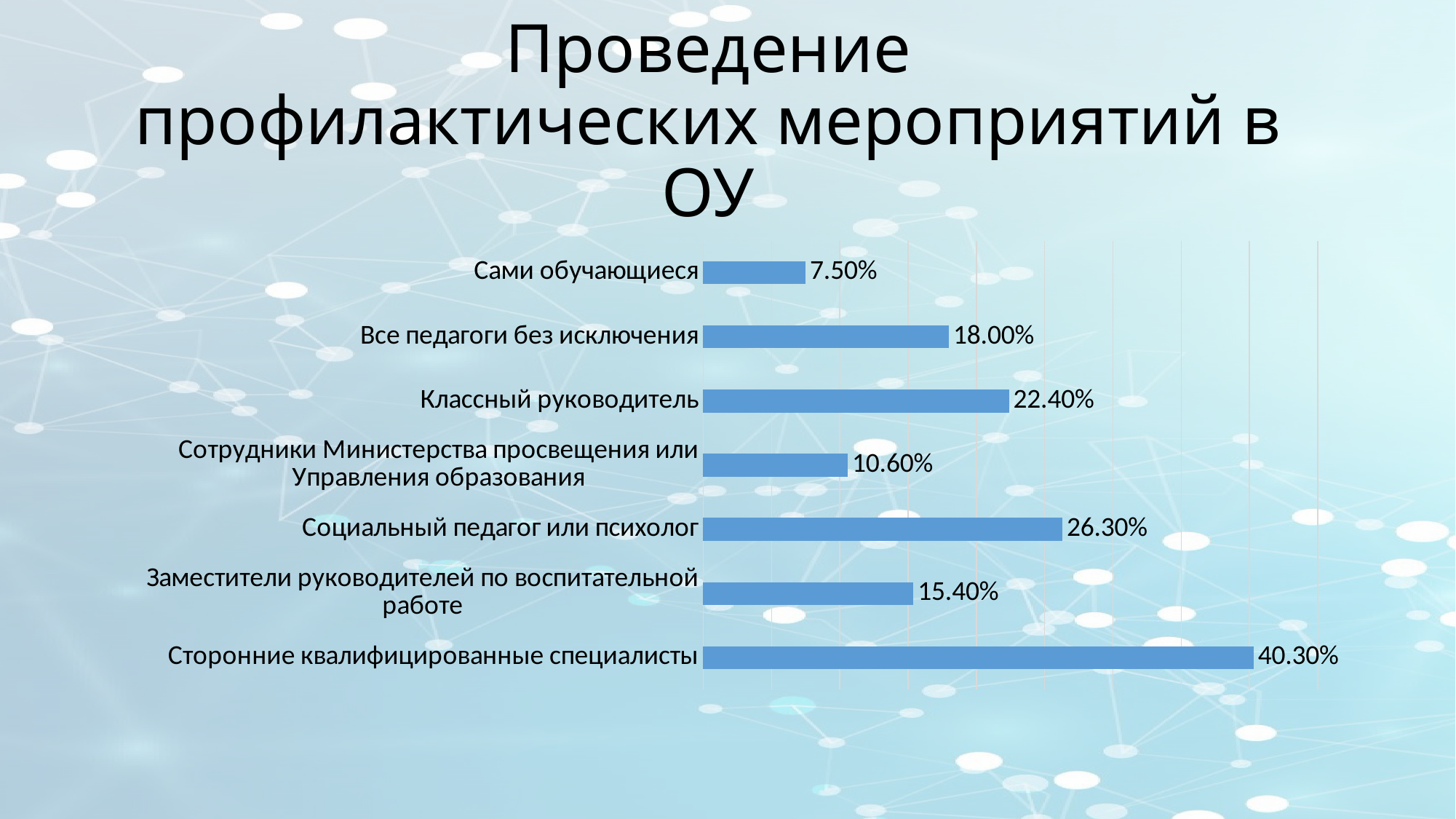
What is the difference between the values for Классный руководитель and Все педагоги без исключения? 4.40% What is the difference between the values for Сторонние квалифицированные специалисты and Сами обучающиеся? 32.80% How many categories are shown in the chart? 7 What is the value for Социальный педагог или психолог? 26.30% What is the value for Сторонние квалифицированные специалисты? 40.30% What is the title of the slide? Проведение профилактических мероприятий в ОУ What is the value for Сами обучающиеся? 7.50% Which is larger: the value for Сотрудники Министерства просвещения или Управления образования or the value for Заместители руководителей по воспитательной работе? Заместители руководителей по воспитательной работе Which category has the lowest value? Сами обучающиеся Which category has the highest value? Сторонние квалифицированные специалисты What is the value for Заместители руководителей по воспитательной работе? 15.40% What kind of chart is shown on the slide? Bar chart